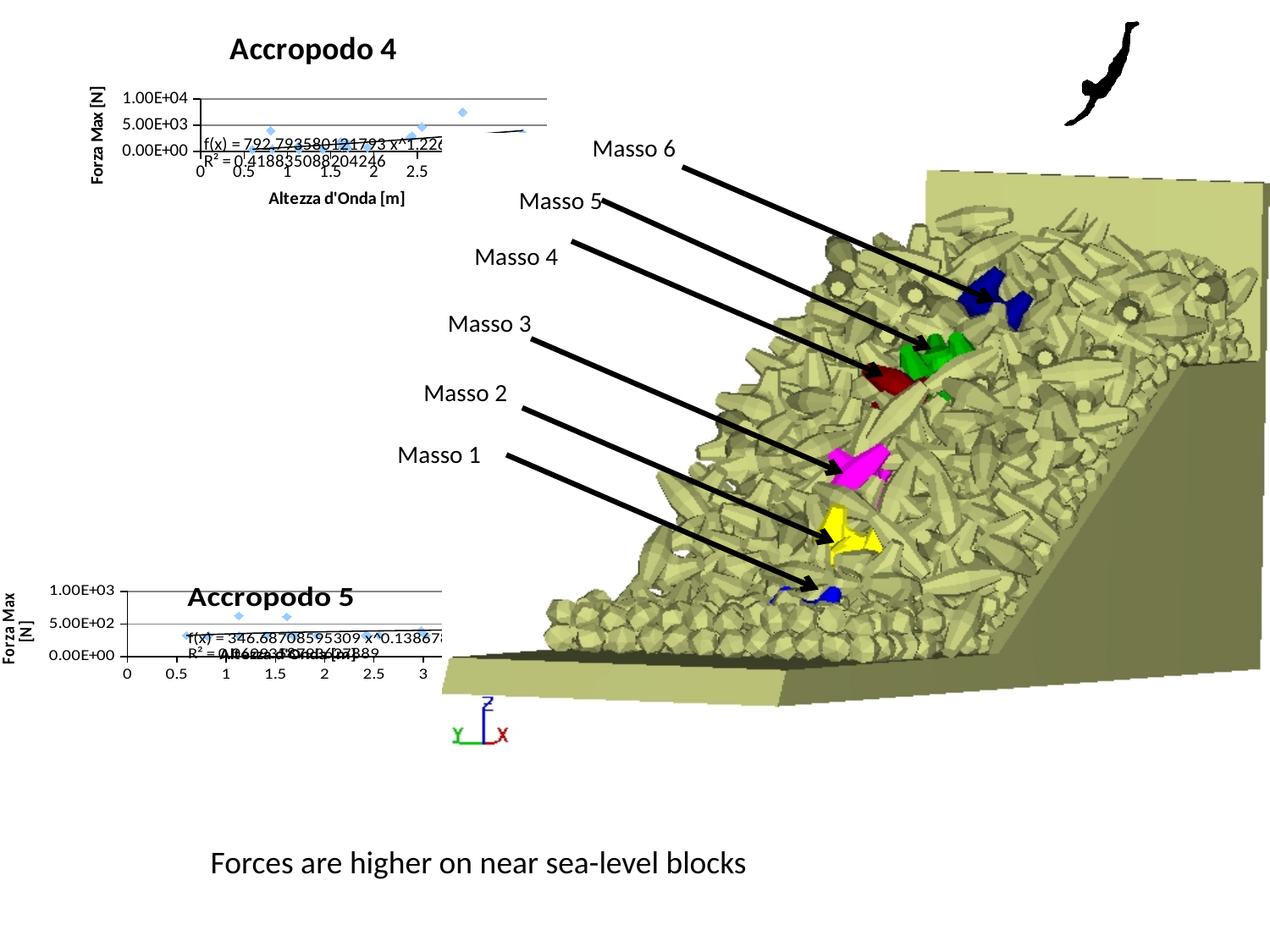
In the "Accropodo 4" chart, do the plotted values generally rise or fall as wave height increases along the x axis? rise What kind of chart is the "Accropodo 5" chart? scatter chart In the "Accropodo 4" chart, what is the title of the y axis? Forza Max [N] What is the highest y-axis tick shown on the "Accropodo 4" chart? 1.00E+04 What kind of chart is the "Accropodo 4" chart? scatter chart In the "Accropodo 4" chart, is the value plotted at the smallest wave height greater or less than 5.00E+03? less What is the highest y-axis tick shown on the "Accropodo 5" chart? 1.00E+03 In the "Accropodo 4" chart, what is the title of the x axis? Altezza d'Onda [m] In the "Accropodo 5" chart, is the highest plotted value greater or less than 1.00E+03? less In the "Accropodo 4" chart, is the highest plotted value greater or less than 5.00E+03? greater